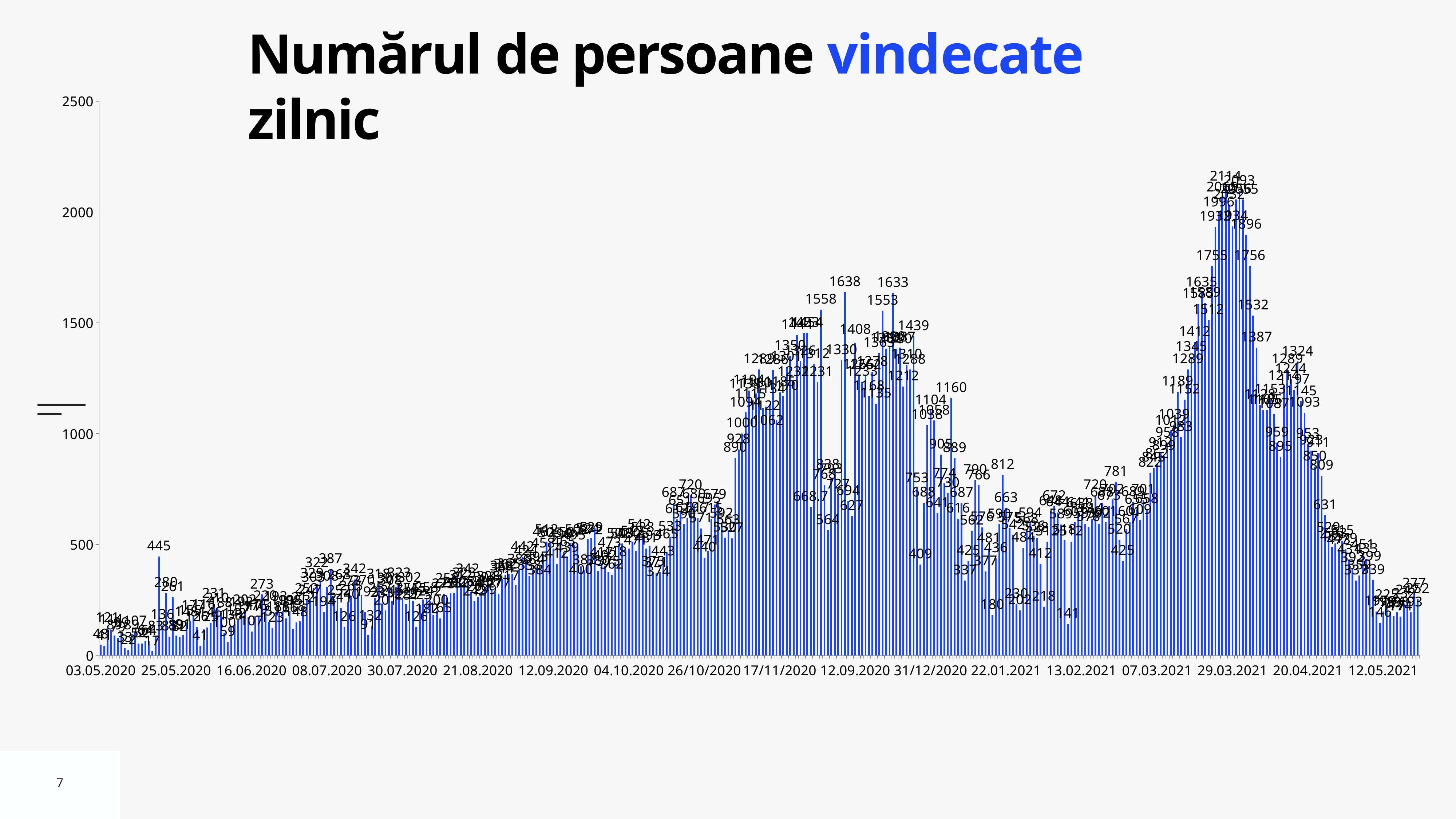
What is the value of the tall isolated bar labelled just before 25.05.2020? 445 Is the value of the first bar at 03.05.2020 greater or less than 500? less What is the highest value labelled on the chart? 2114 Which is larger, the bar labelled 1638 or the bar labelled 1558? 1638 What is the value of the highest labelled bar in the November 2020 peak, just before 12.09.2020 on the axis? 1638 Do the values rise or fall between 07.03.2021 and 29.03.2021? rise What is the difference between the bars labelled 1638 and 1558? 80 Is the peak value around 29.03.2021 greater or less than 2000? greater What kind of chart is shown on the slide? bar chart What is the highest tick value shown on the vertical axis? 2500 What is the title of the chart? Numărul de persoane vindecate zilnic Do the values rise or fall between 29.03.2021 and 12.05.2021? fall